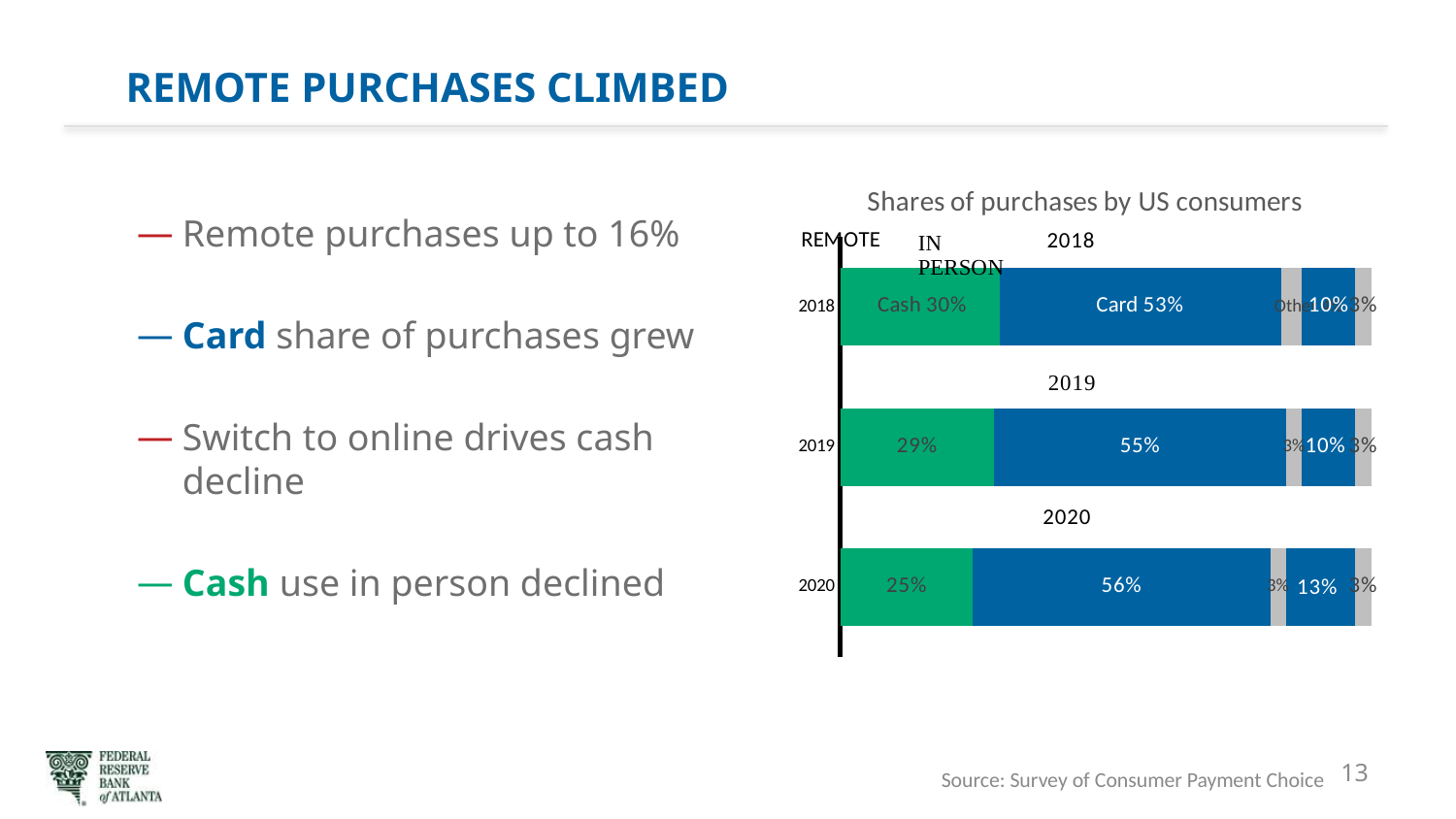
Which year has the highest in-person card share of purchases? 2020 What is the cash share of purchases in 2018? Cash 30% By how many percentage points did the cash share fall from 2018 to 2020? 5 percentage points How many years (bars) does the chart show? 3 What kind of chart is shown on the slide? Stacked bar chart Which year has the lowest cash share of purchases? 2020 What is the card share of purchases in 2018? Card 53% What is the remote card share of purchases in 2020? 13% Does the cash share of purchases rise or fall from 2018 to 2020? Fall What is the title of the chart on the slide? Shares of purchases by US consumers What is the cash share of purchases in 2020? 25% What is the in-person card share of purchases in 2019? 55%